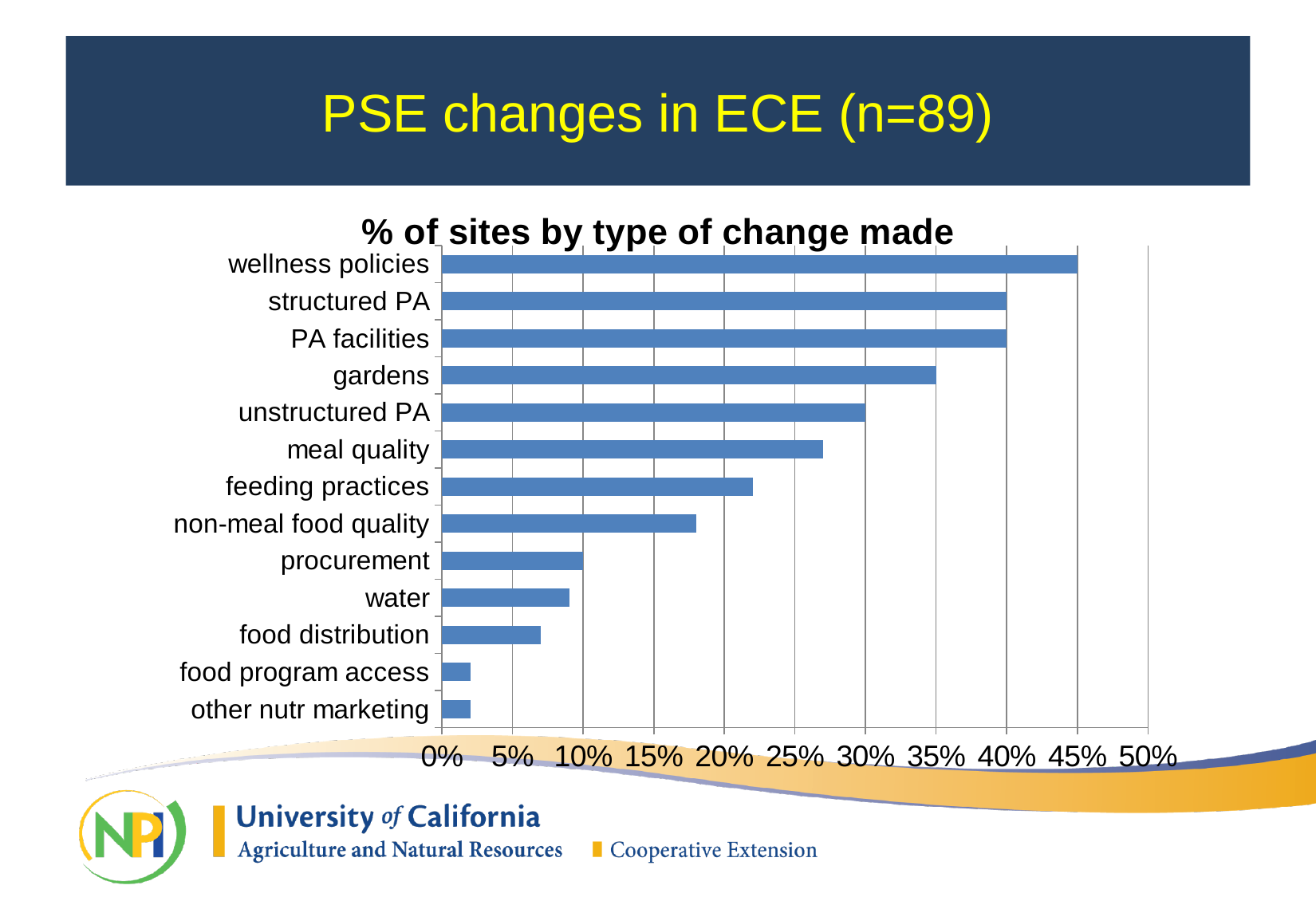
What is the title of the chart? % of sites by type of change made Is the value for meal quality greater or less than 25%? greater What percentage of sites made changes to procurement? 10% Is the value for water greater or less than 10%? less What kind of chart is shown on the slide? bar chart Do the bar values increase or decrease going from the top of the chart to the bottom? decrease Which type of change has the highest percentage of sites? wellness policies How many types of change are listed on the chart? 13 What percentage of sites made changes to gardens? 35% Is the value for feeding practices greater or less than 25%? less What percentage of sites made changes to wellness policies? 45% Which is larger, the value for unstructured PA or the value for non-meal food quality? unstructured PA